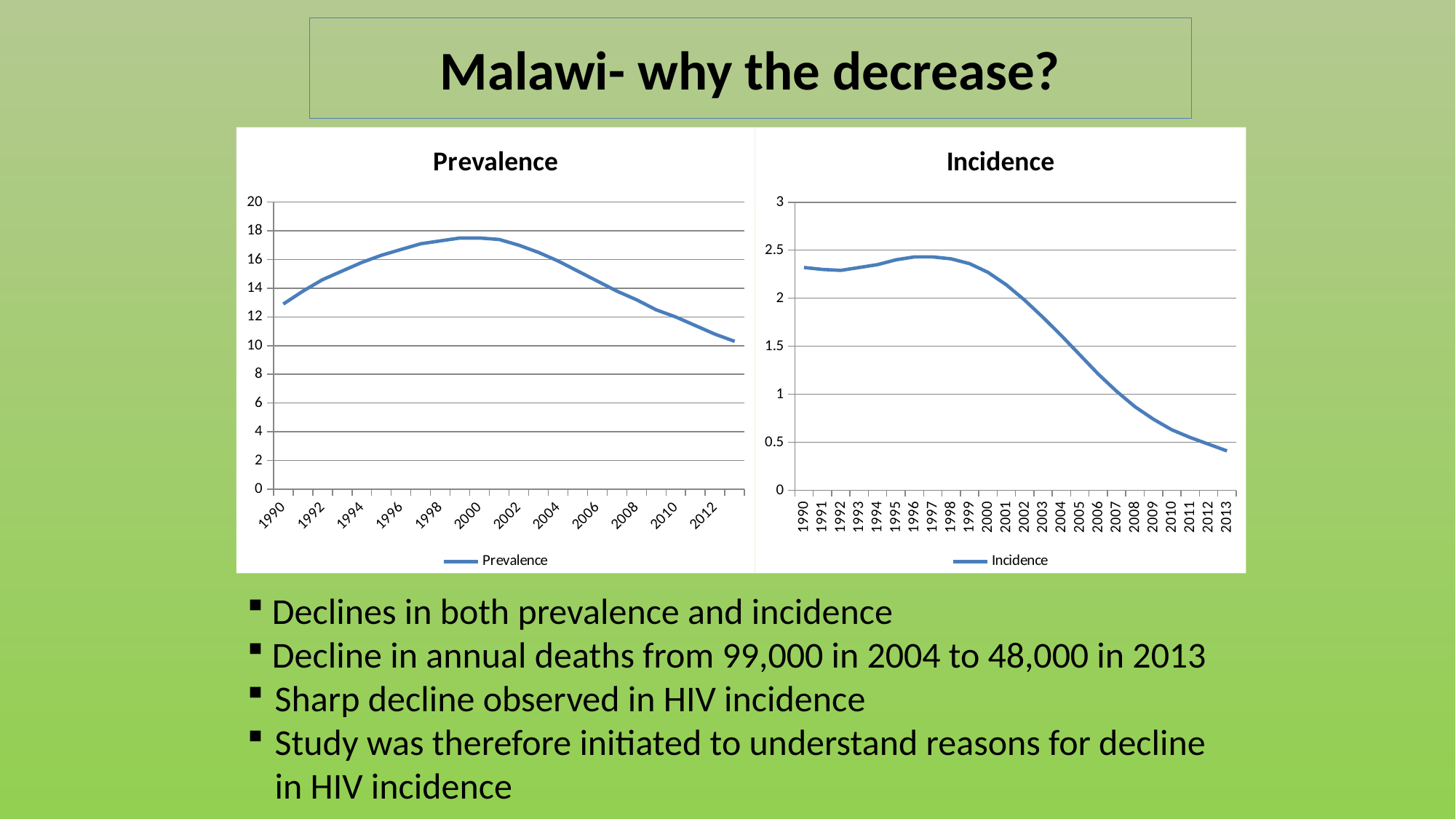
In the Incidence chart, is the value for 2003 greater or less than 2? less In the Incidence chart, is the value for 2013 greater or less than 0.5? less What kind of chart is the Prevalence chart? line chart In the Prevalence chart, is the value for 2000 greater or less than 16? greater In the Incidence chart, does the value rise or fall between 2000 and 2013? fall In the Incidence chart, which year has the lowest value? 2013 In the Prevalence chart, around which year does the line reach its highest value? 2000 How many series does the legend of the Incidence chart list? 1 What kind of chart is the Incidence chart? line chart